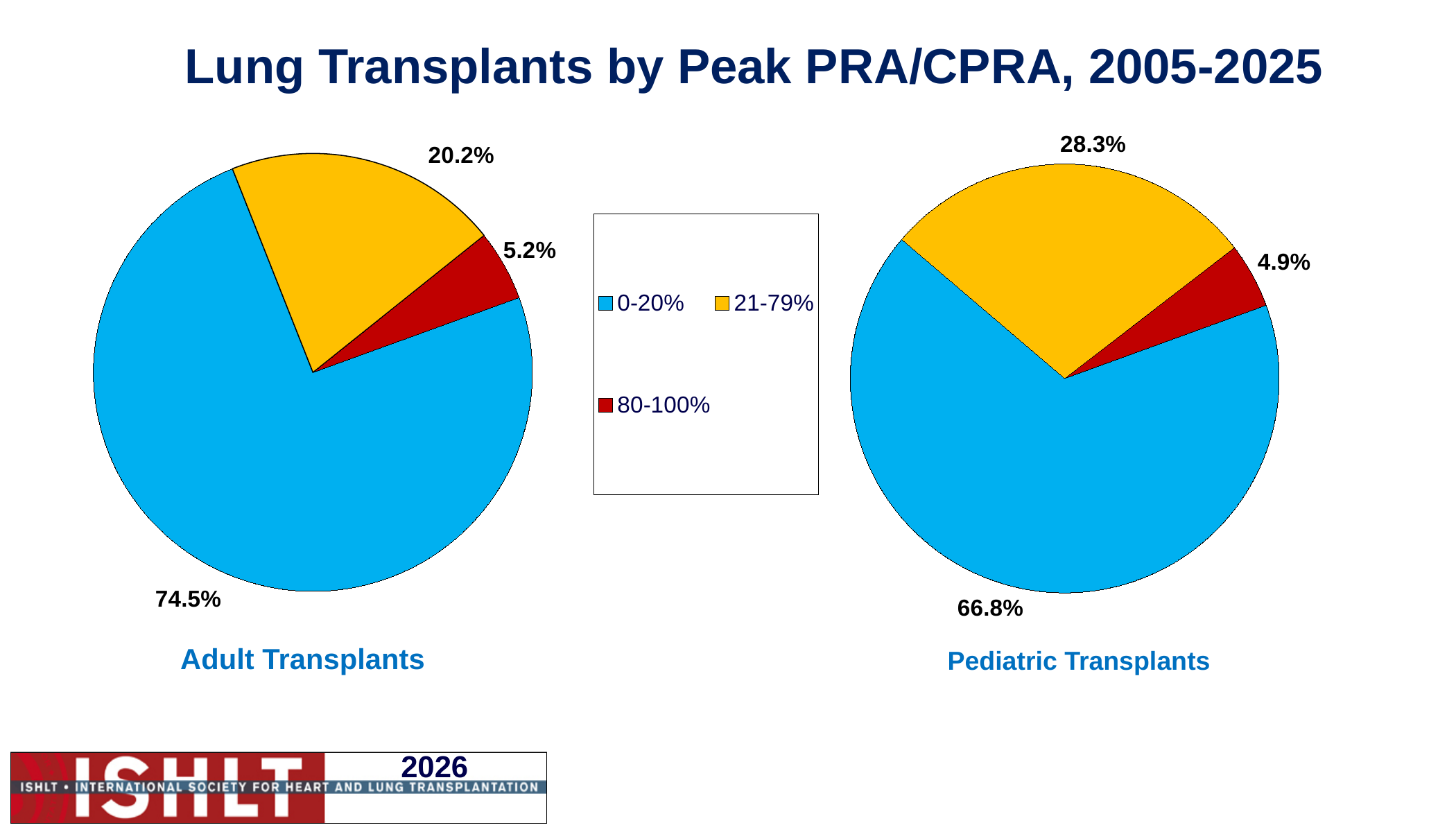
In the Pediatric Transplants pie chart, which category has the smallest slice? 80-100% In the Adult Transplants pie chart, which category has the largest slice? 0-20% Which is larger: the 0-20% share in the Adult Transplants chart or the 0-20% share in the Pediatric Transplants chart? Adult Transplants In the Adult Transplants pie chart, what is the value for the 80-100% category? 5.2% What is the difference between the 21-79% share in the Pediatric Transplants chart and the 21-79% share in the Adult Transplants chart? 8.1% What kind of chart is used for the Adult Transplants data? Pie chart In the Pediatric Transplants pie chart, what share of lung transplants had a peak PRA/CPRA of 21-79%? 28.3% What is the title of the slide's charts? Lung Transplants by Peak PRA/CPRA, 2005-2025 How many categories does the legend list? 3 Which colour represents the 80-100% category in the legend? Red In the Adult Transplants pie chart, what share of lung transplants had a peak PRA/CPRA of 0-20%? 74.5% In the Pediatric Transplants pie chart, what is the value for the 80-100% category? 4.9%